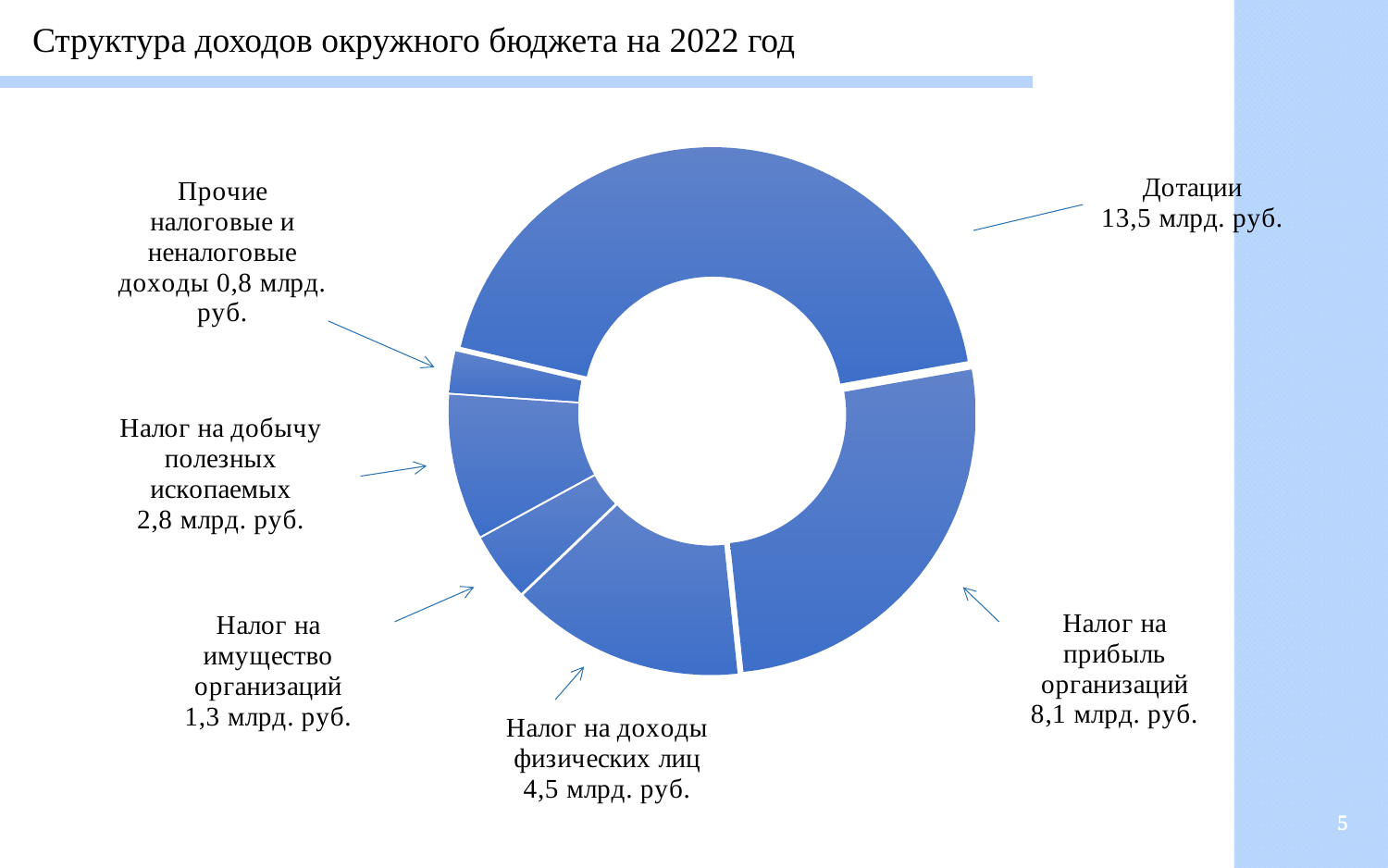
How many categories are shown in the chart? 6 Which is larger: Налог на добычу полезных ископаемых or Налог на имущество организаций? Налог на добычу полезных ископаемых What is the value for Дотации? 13,5 млрд. руб. What is the total of all the values shown in the chart? 31,0 млрд. руб. What is the title of the chart on the slide? Структура доходов окружного бюджета на 2022 год Which category has the largest value? Дотации What is the value for Налог на прибыль организаций? 8,1 млрд. руб. What is the difference between Дотации and Налог на прибыль организаций? 5,4 млрд. руб. What is the value for Налог на добычу полезных ископаемых? 2,8 млрд. руб. What kind of chart is shown on the slide? Donut (pie) chart Which category has the smallest value? Прочие налоговые и неналоговые доходы What is the value for Налог на доходы физических лиц? 4,5 млрд. руб.